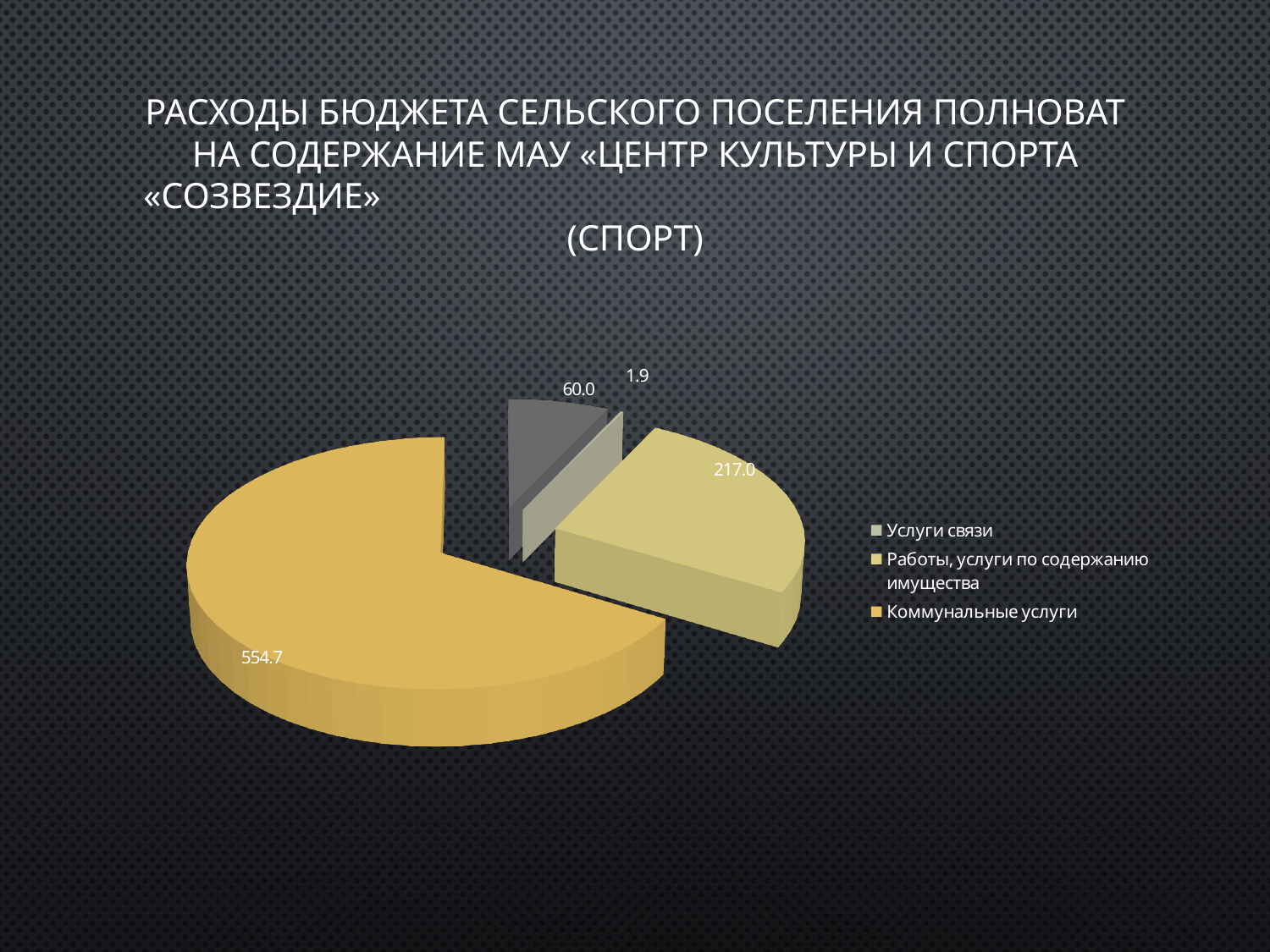
What is the smallest data label shown on the pie? 1.9 What is the value for Работы, услуги по содержанию имущества? 217.0 What kind of chart is shown on the slide? pie chart What is the value for Коммунальные услуги? 554.7 What is the difference between the values for Работы, услуги по содержанию имущества and Услуги связи? 215.1 Which category has the largest slice of the pie? Коммунальные услуги What word appears in parentheses at the end of the chart title? (СПОРТ) How many categories does the legend list? 3 What is the value for Услуги связи? 1.9 Which is larger, Услуги связи or Работы, услуги по содержанию имущества? Работы, услуги по содержанию имущества What is the difference between the values for Коммунальные услуги and Работы, услуги по содержанию имущества? 337.7 What colour is the slice for Коммунальные услуги? gold (yellow-orange)